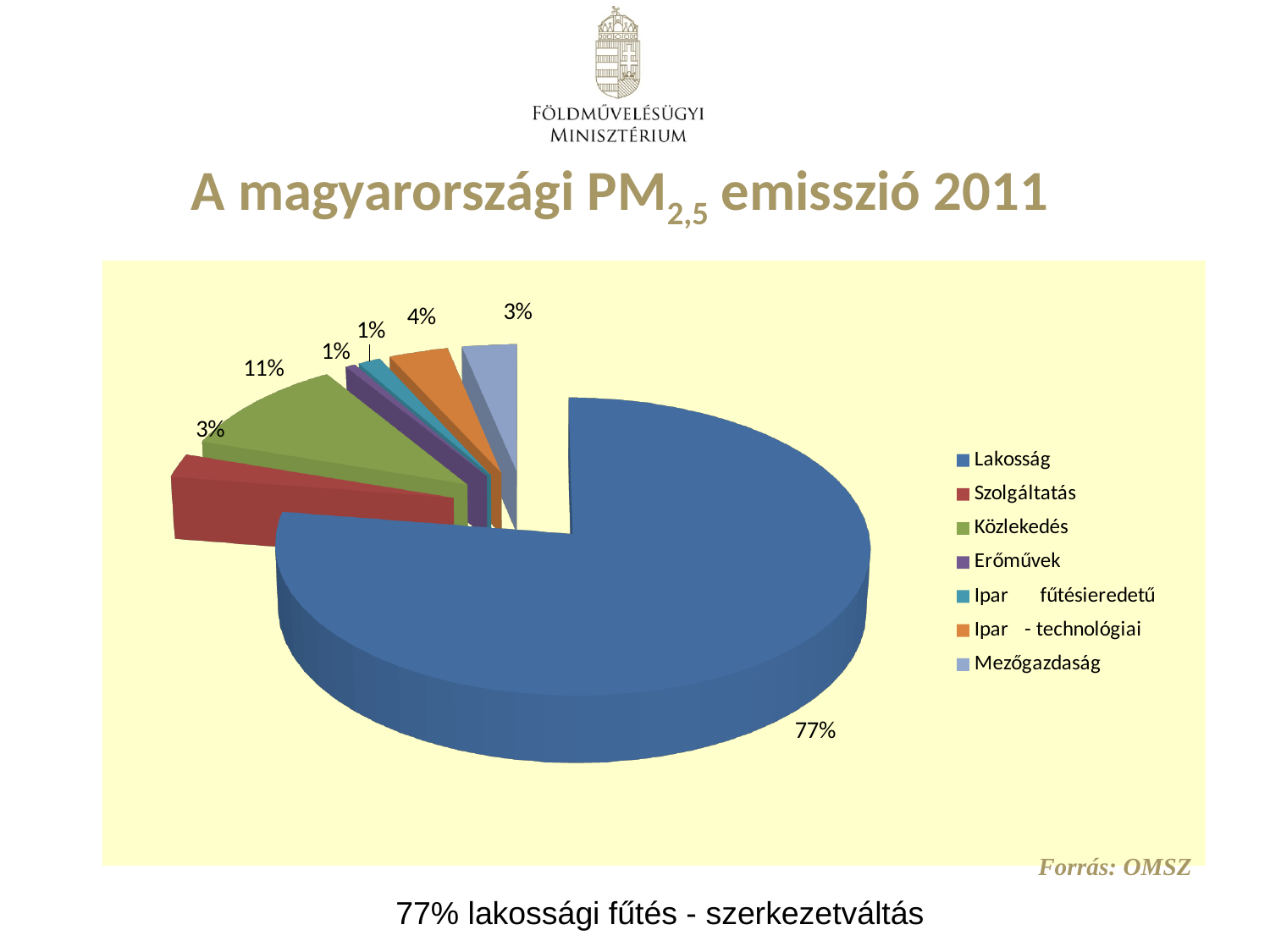
Which category has the largest slice of the pie? Lakosság What source is cited for the chart? OMSZ What share of the pie does Lakosság have? 77% What is the value shown for Ipar - technológiai? 4% Which is larger, Közlekedés or Szolgáltatás? Közlekedés What is the difference between the Lakosság share and the Közlekedés share? 66% What is the title of the slide containing the chart? A magyarországi PM2,5 emisszió 2011 How many categories does the legend list? 7 What is the value shown for Mezőgazdaság? 3% What is the value shown for Erőművek? 1% What type of chart is shown on the slide? pie chart What is the value shown for Közlekedés? 11%